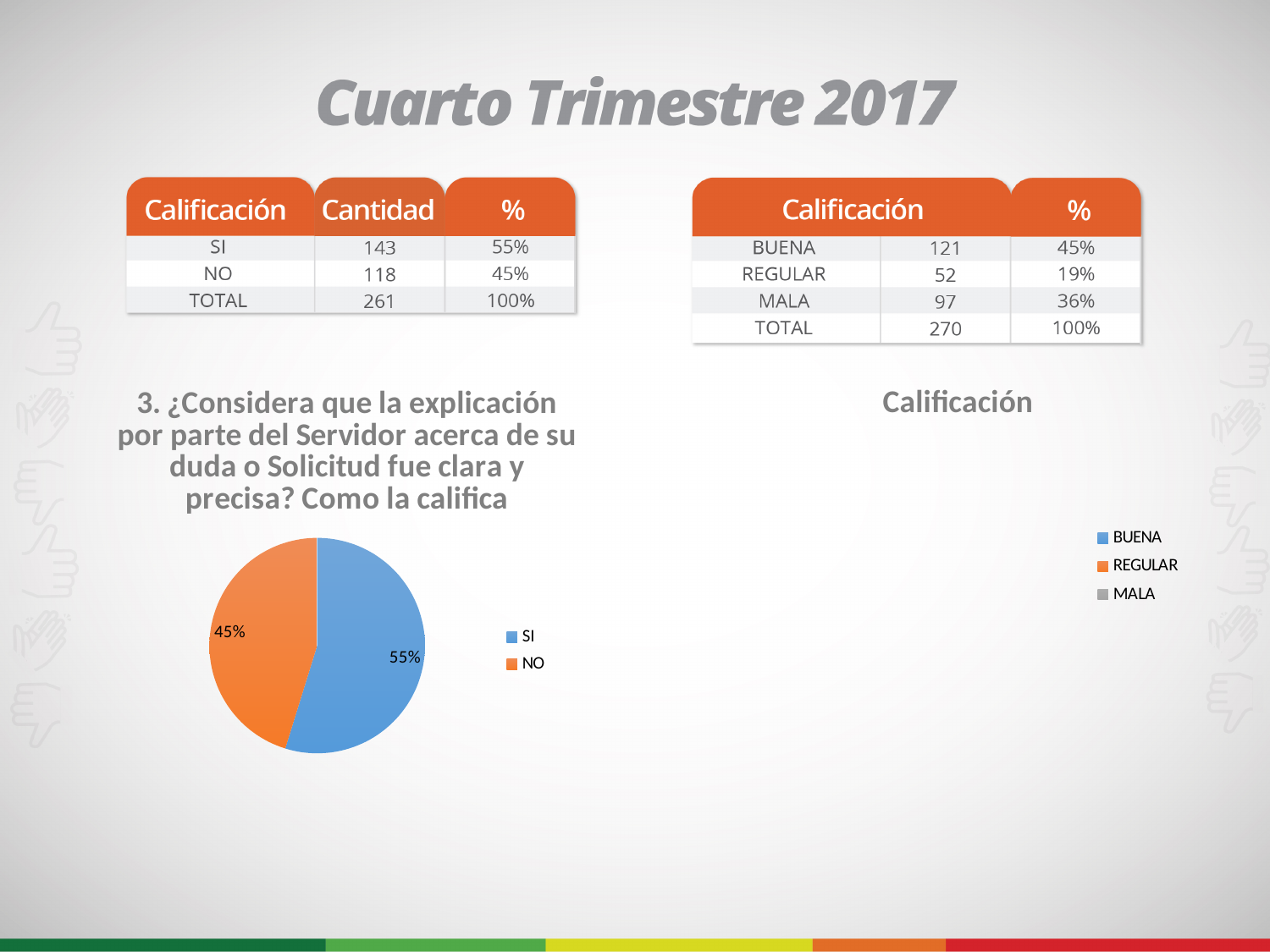
In the pie chart on the left, what percentage is shown for NO? 45% In the pie chart on the left, which category has the smallest slice? NO In the pie chart on the left, what share of the pie does the SI slice represent? 55% What entries are listed in the legend of the chart titled 'Calificación' on the right? BUENA, REGULAR, MALA In the pie chart on the left, what percentage is shown for SI? 55% How many slices does the pie chart on the left have? 2 What kind of chart is the chart on the left of the slide? pie chart In the pie chart on the left, which category has the largest slice? SI How many entries does the legend of the pie chart on the left list? 2 In the pie chart on the left, what colour is the SI slice? blue In the pie chart on the left, what is the difference between the SI and NO percentages? 10% In the pie chart on the left, which is larger, SI or NO? SI